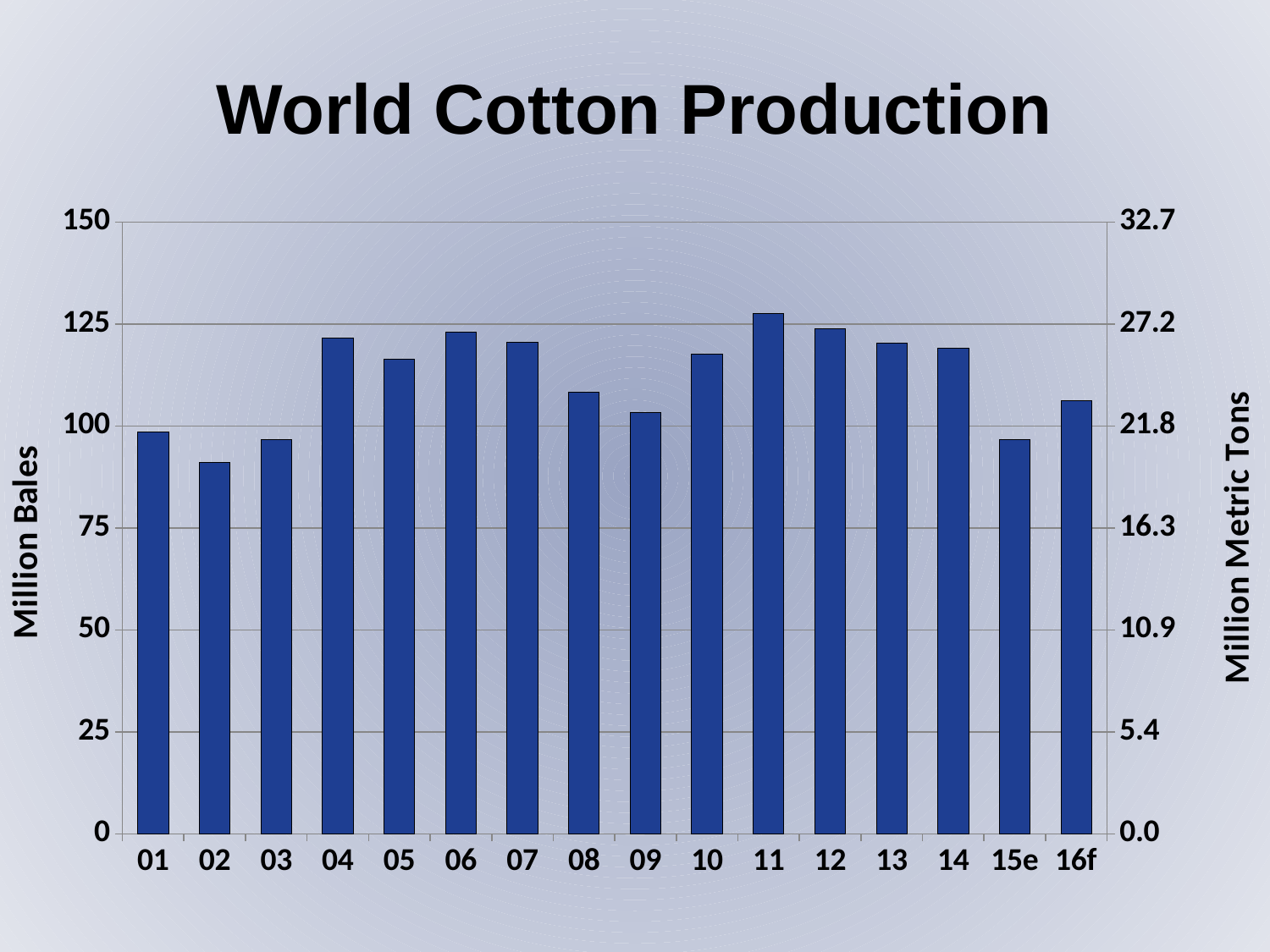
Is the value for 02 greater or less than 100 million bales? less What is the label of the left vertical axis? Million Bales How many bars (years) are plotted in the chart? 16 Is the value for 15e greater or less than 100 million bales? less Which year has the highest world cotton production? 11 What is the title of the chart? World Cotton Production Do the values rise or fall from 11 to 15e? fall Which year has the lowest world cotton production? 02 Is the value for 16f greater or less than 100 million bales? greater What type of chart is shown on the slide? bar chart Which is larger, the value for 04 or the value for 01? 04